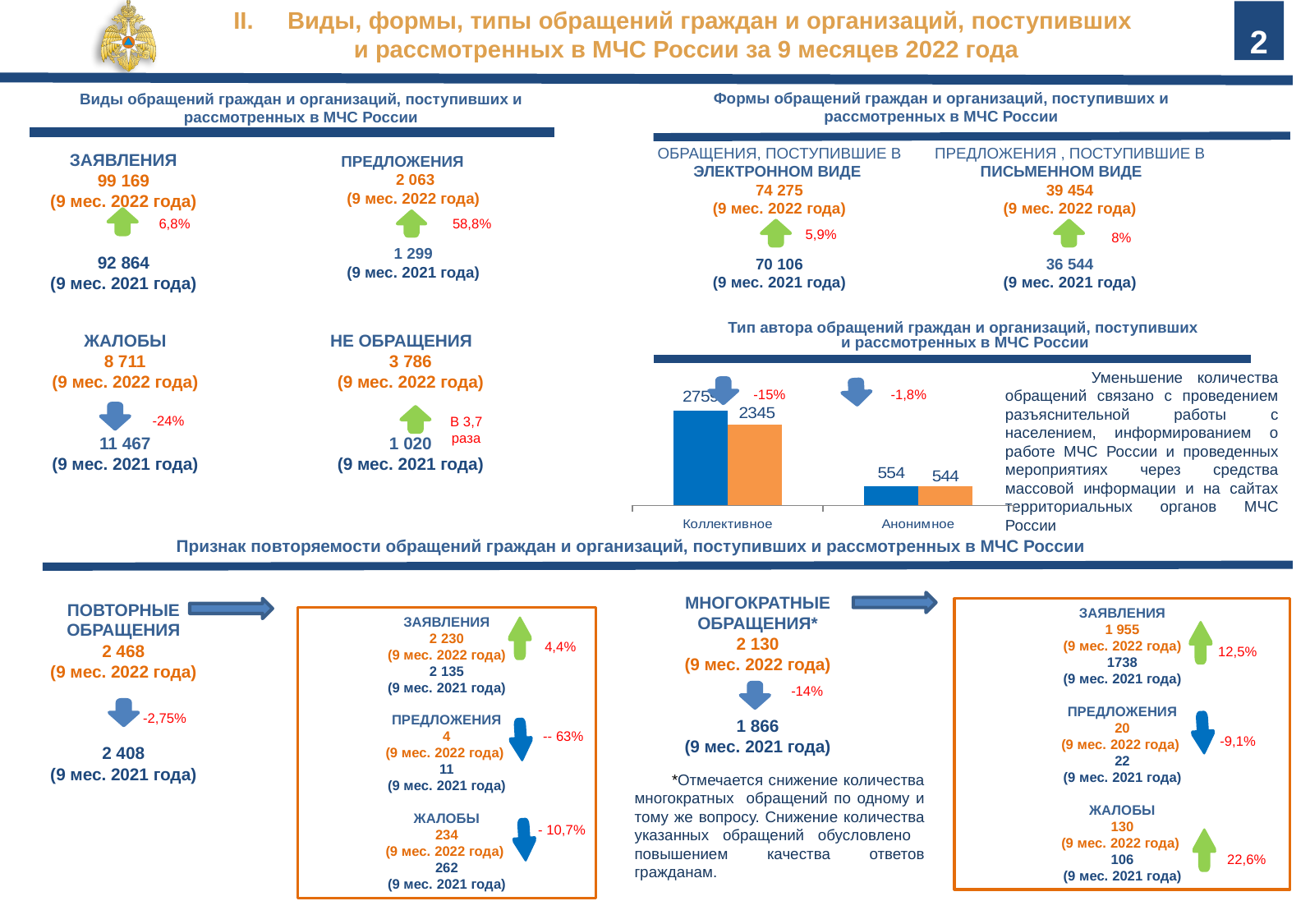
In the "Тип автора обращений" bar chart, what percentage change is shown next to the arrow above Коллективное? -15% In the "Тип автора обращений" bar chart, which category has the higher orange bar, Коллективное or Анонимное? Коллективное In the "Тип автора обращений" bar chart, what is the value of the orange bar for Анонимное? 544 What kind of chart is shown under the heading "Тип автора обращений граждан и организаций"? bar chart In the "Тип автора обращений" bar chart, what is the value of the blue bar for Анонимное? 554 In the "Тип автора обращений" bar chart, which category has the highest bars overall? Коллективное In the "Тип автора обращений" bar chart, how many categories are shown on the x axis? 2 In the "Тип автора обращений" bar chart, what is the difference between the orange bar for Коллективное and the orange bar for Анонимное? 1801 In the "Тип автора обращений" bar chart, what is the value of the orange bar for Коллективное? 2345 In the "Тип автора обращений" bar chart, which bar is taller for Анонимное, the blue one or the orange one? blue In the "Тип автора обращений" bar chart, what percentage change is shown next to the arrow above Анонимное? -1,8% In the "Тип автора обращений" bar chart, what is the difference between the blue and orange bars for Анонимное? 10